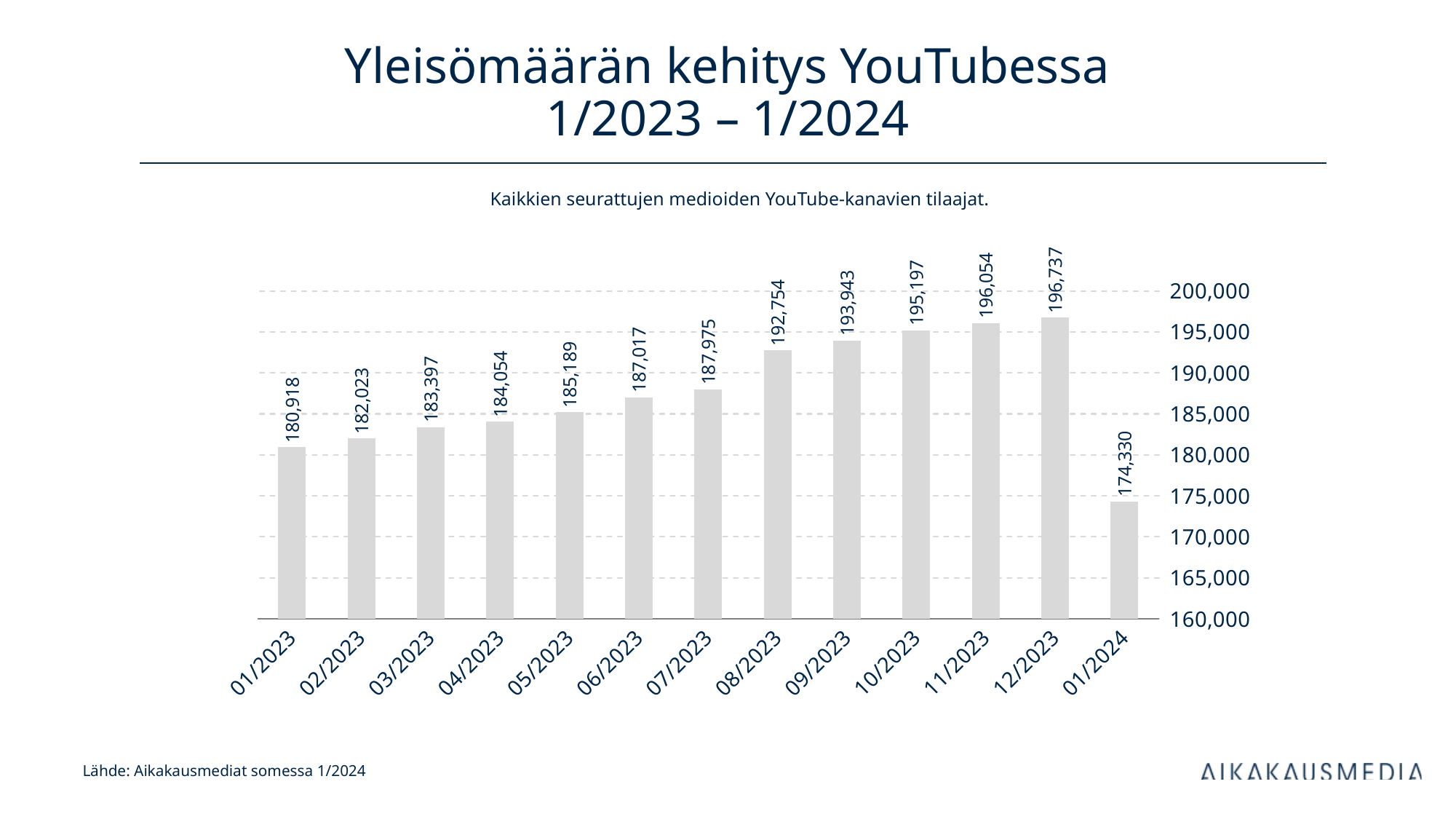
What is the value for 12/2023? 196,737 What is the value for 08/2023? 192,754 What is the value for 01/2023? 180,918 Which month has the highest value? 12/2023 Which is larger, the value for 06/2023 or the value for 09/2023? 09/2023 What is the difference between the values for 12/2023 and 01/2024? 22,407 What kind of chart is shown on the slide? Bar chart What is the difference between the values for 01/2023 and 12/2023? 15,819 Which month has the lowest value? 01/2024 Do the values rise or fall from 01/2023 to 12/2023? Rise How many months are shown on the x axis? 13 What is the value for 01/2024? 174,330